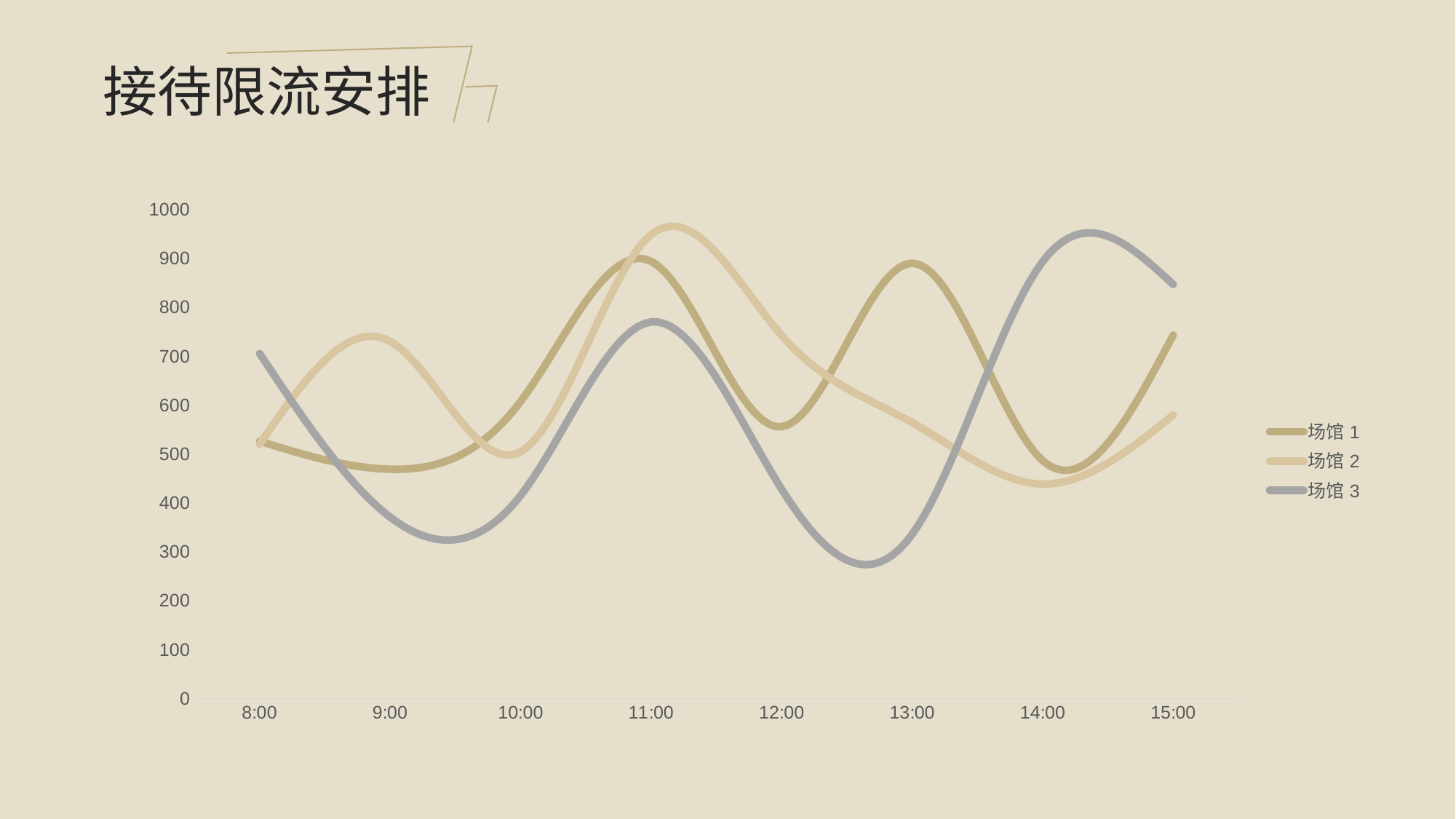
How many series does the legend list? 3 Is the value for 场馆 1 at 11:00 greater or less than 800? greater At 13:00, which is larger: 场馆 1 or 场馆 3? 场馆 1 Is the value for 场馆 3 at 13:00 greater or less than 400? less How many time points are shown on the x axis? 8 Is the value for 场馆 3 at 14:00 greater or less than 800? greater What kind of chart is shown on the slide? line chart What is the title of the slide containing the chart? 接待限流安排 What are the three legend entries of the chart? 场馆 1, 场馆 2, 场馆 3 At 9:00, which is larger: 场馆 2 or 场馆 3? 场馆 2